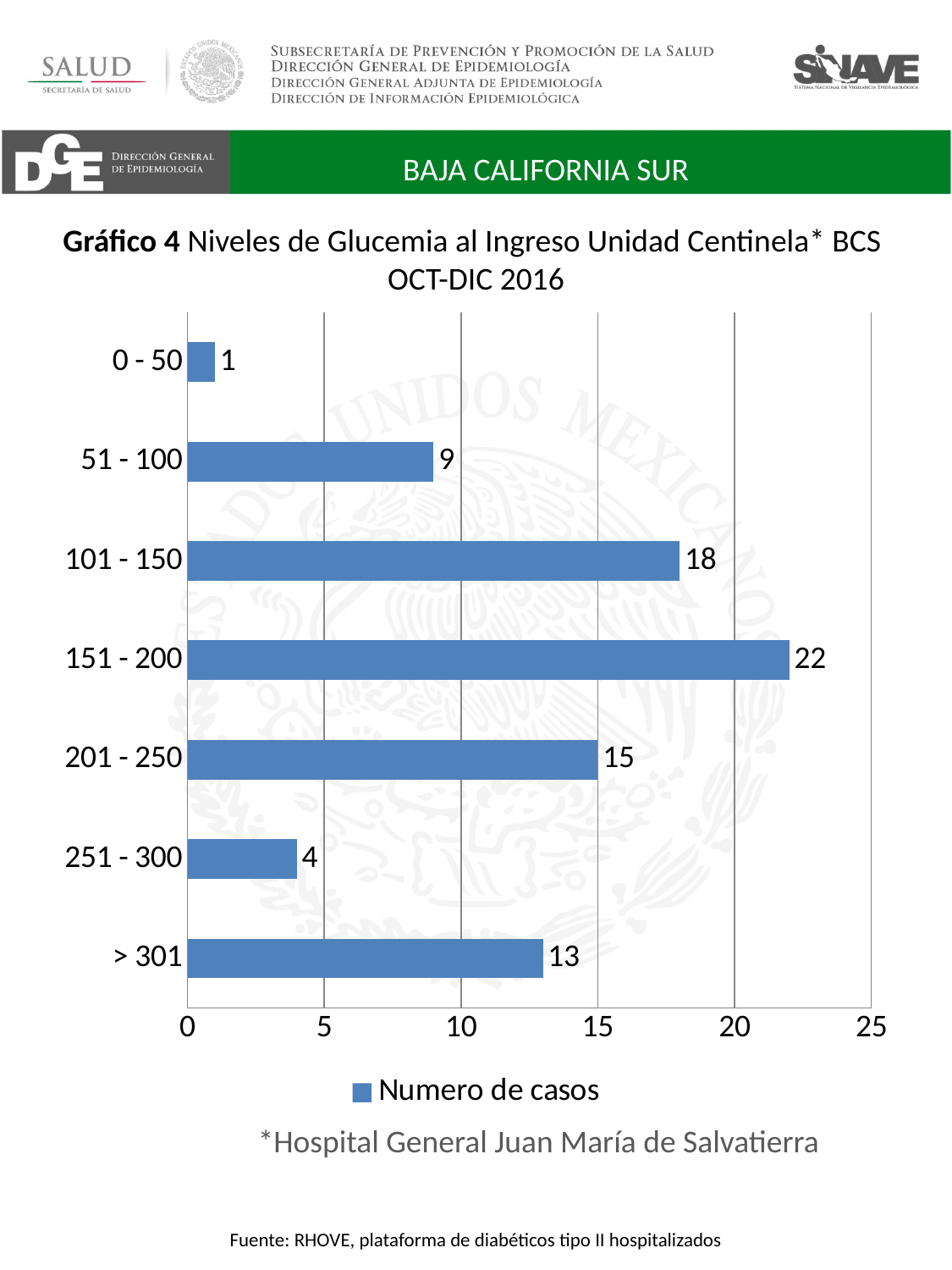
What is the number of cases for the > 301 category? 13 Which has more cases, the 251 - 300 category or the > 301 category? > 301 What kind of chart is shown on the slide? Bar chart How many series does the legend list? 1 How many glucose level categories are shown in the chart? 7 Which glucose level category has the highest number of cases? 151 - 200 Is the value for 201 - 250 greater or less than 10? greater What is the difference in number of cases between the 101 - 150 and 201 - 250 categories? 3 What is the number of cases for the 151 - 200 glucose level category? 22 What is the number of cases for the 51 - 100 category? 9 Which glucose level category has the lowest number of cases? 0 - 50 What is the legend entry for the series shown in the chart? Numero de casos